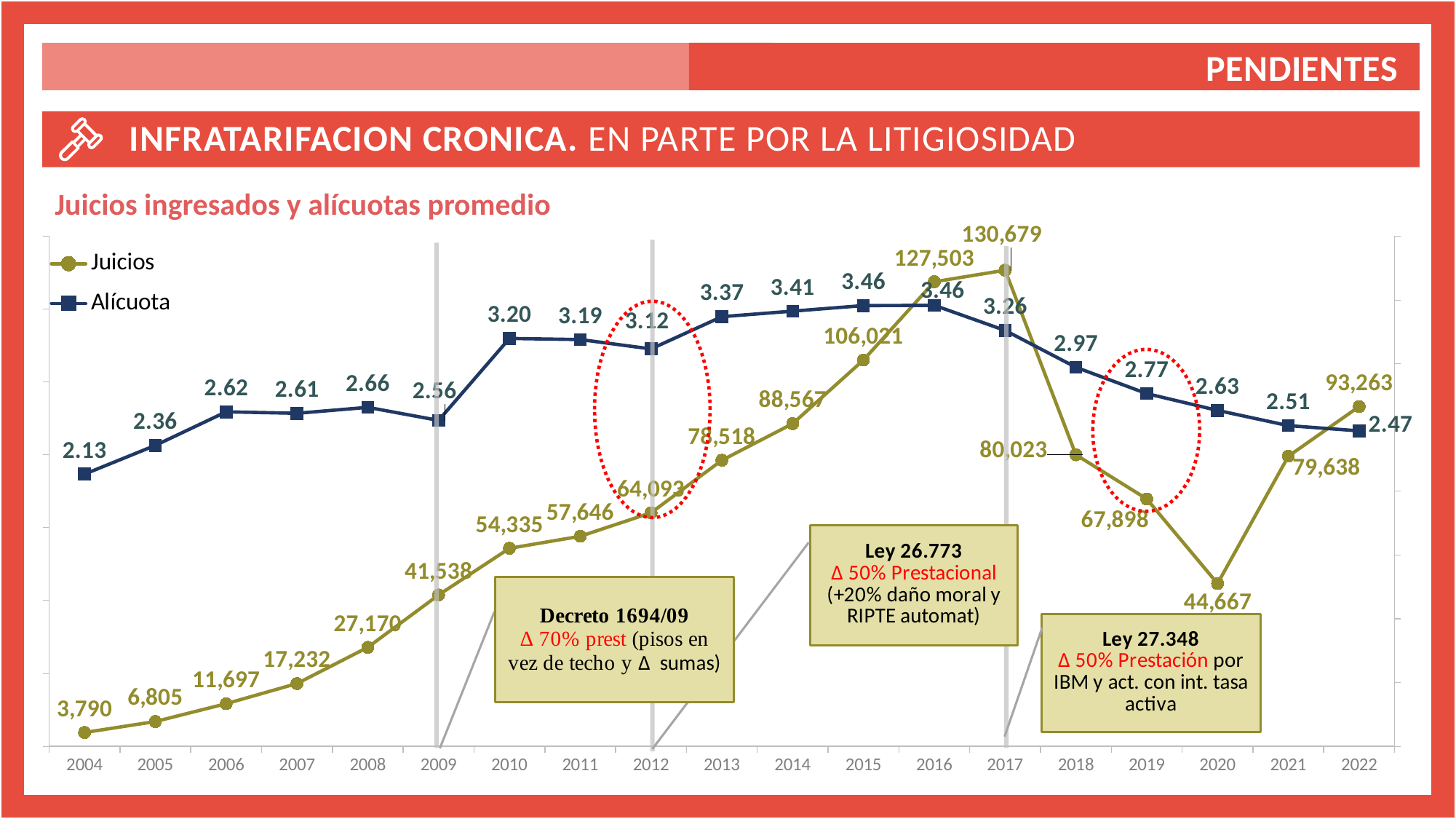
What is the difference between the Juicios values for 2017 and 2016? 3,176 What is the difference between the Alícuota values for 2015 and 2004? 1.33 How many series does the legend list? 2 In which year is the Juicios value highest? 2017 What is the title of the chart? Juicios ingresados y alícuotas promedio Do the Juicios values rise or fall from 2004 to 2017? rise In which year is the Alícuota value lowest? 2004 What is the value of Alícuota in 2019? 2.77 What type of chart is shown on the slide? line chart How many years are shown on the x axis? 19 Which year has a larger Juicios value, 2019 or 2020? 2019 What is the value of Juicios in 2012? 64,093